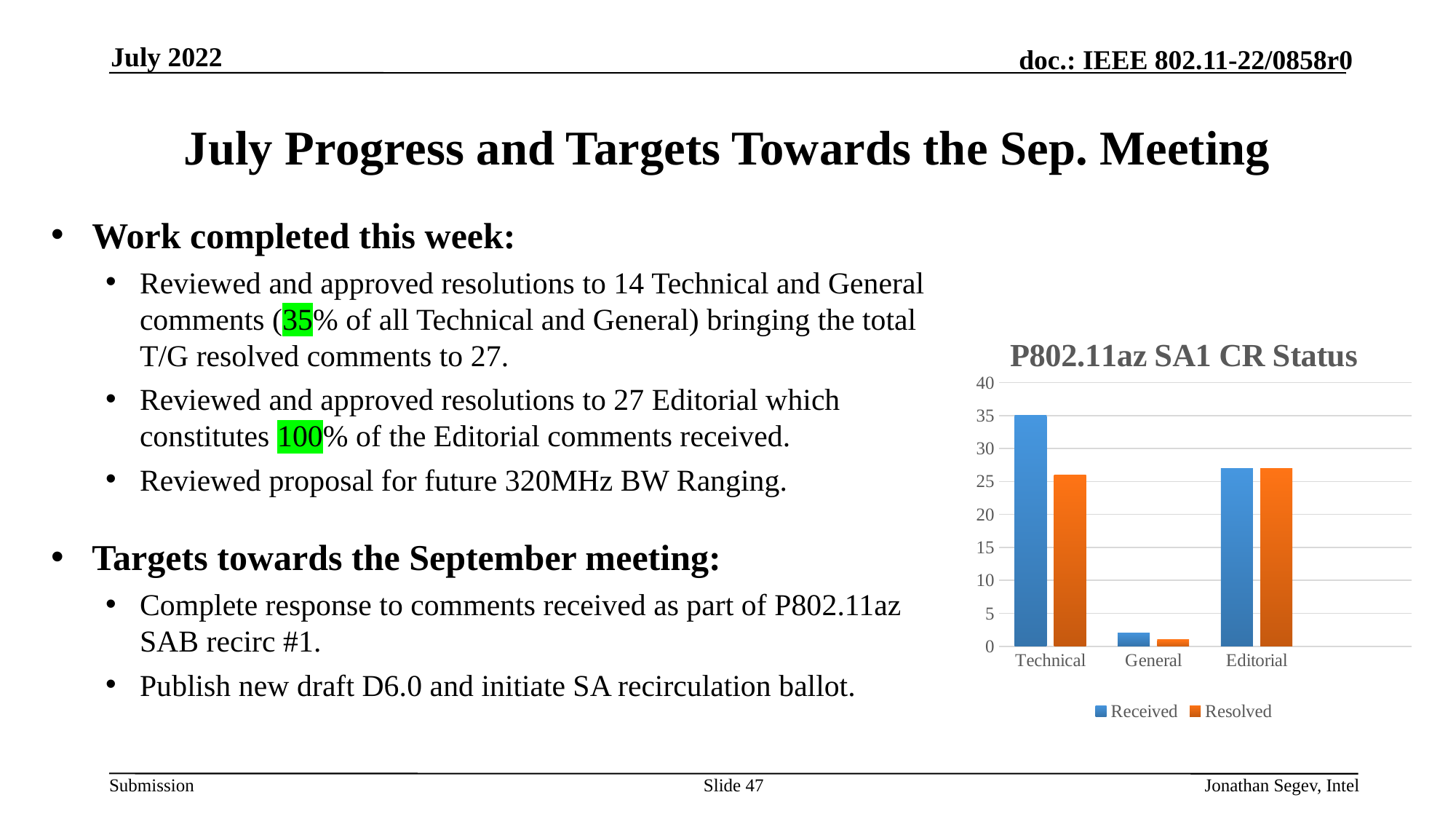
How many series does the chart legend list? 2 What is the title of the chart? P802.11az SA1 CR Status Is the Resolved value for Technical greater or less than 30? less How many categories are shown on the x axis of the chart? 3 Is the Received value for General greater or less than 5? less Which series is shown in orange in the chart? Resolved Which category has the lowest Resolved value? General Is the Received value for Editorial greater or less than 25? greater Which category has the highest Received value? Technical For Technical, which is larger, Received or Resolved? Received What type of chart is shown on the slide? bar chart